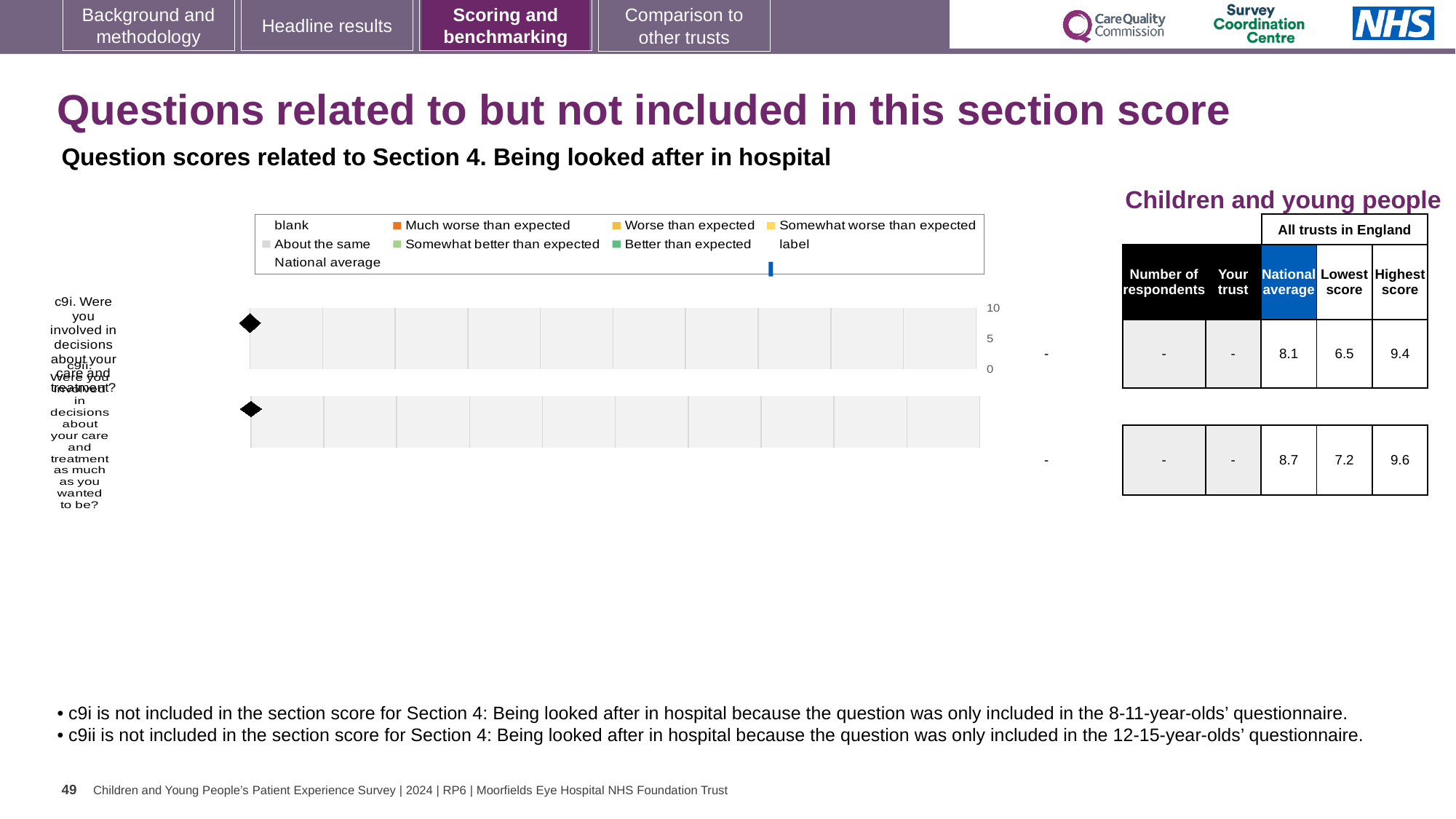
In the table to the right, which row has the higher national average, c9i or c9ii? c9ii In the table to the right, what is the difference between the national averages of c9ii and c9i? 0.6 In the table to the right, what is the difference between the highest and lowest score for c9ii? 2.4 What is the highest value shown on the chart's axis? 10 In the table to the right, what is the highest score for c9ii (the second row)? 9.6 In the table to the right, what is the national average for c9i (the first row)? 8.1 In the table to the right, what is the lowest score for c9i (the first row)? 6.5 What colour does the legend use for 'Much worse than expected'? orange How many question categories are plotted on the chart? 2 What kind of chart is shown on the slide? bar chart